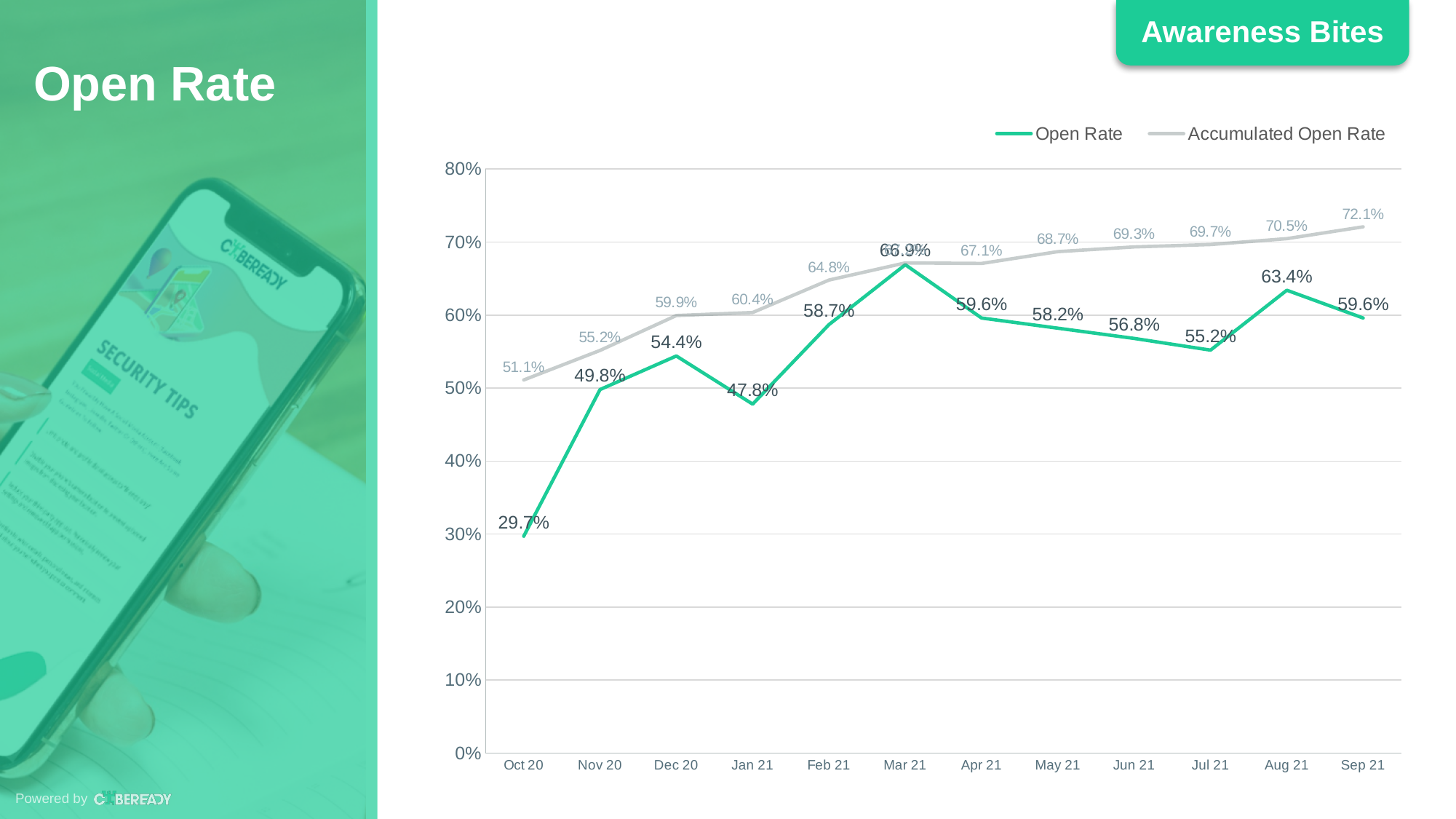
What is the difference between the Open Rate in Mar 21 and Jan 21? 19.1% How many series does the legend list? 2 What is the Open Rate for Aug 21? 63.4% What is the Open Rate for Oct 20? 29.7% Does the Accumulated Open Rate rise or fall from Oct 20 to Sep 21? rise What is the Accumulated Open Rate for Sep 21? 72.1% What type of chart is shown on the slide? line chart How many months are plotted along the x axis? 12 In which month is the Open Rate highest? Mar 21 In which month is the Open Rate lowest? Oct 20 What is the Accumulated Open Rate for Feb 21? 64.8% Which is larger, the Open Rate in Dec 20 or in Jan 21? Dec 20